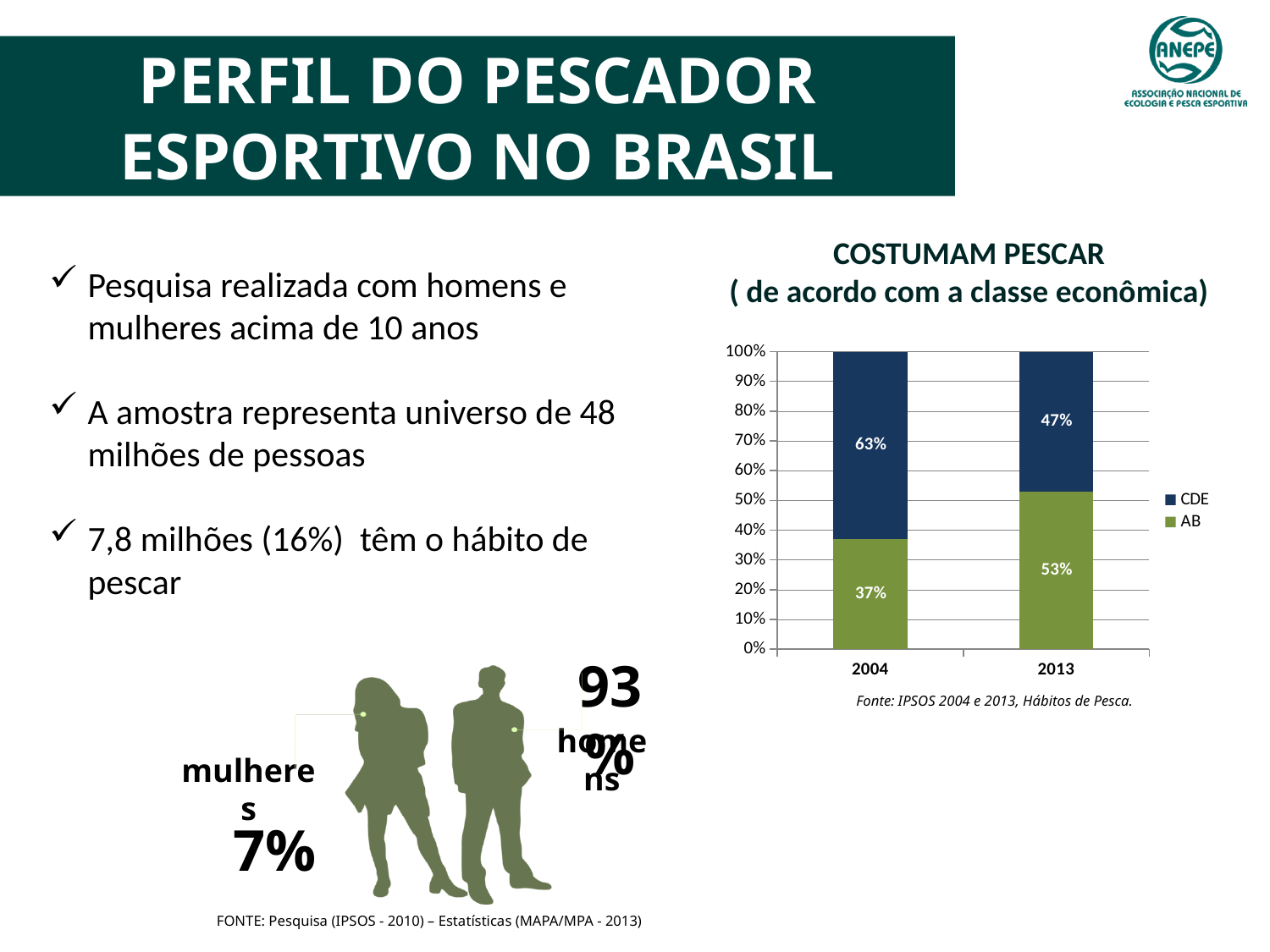
What kind of chart is the 'COSTUMAM PESCAR' chart? Stacked bar chart In the 'COSTUMAM PESCAR' chart, what is the difference between the CDE values for 2004 and 2013? 16% In the 'COSTUMAM PESCAR' chart, which year has the higher value for AB? 2013 In the 'COSTUMAM PESCAR' chart, does the AB value rise or fall from 2004 to 2013? rise In the 'COSTUMAM PESCAR' chart, which year has the lower value for CDE? 2013 What is the value for AB in 2004 in the 'COSTUMAM PESCAR' chart? 37% In the 'COSTUMAM PESCAR' chart, is the AB value in 2004 larger or smaller than the CDE value in 2004? smaller What is the value for CDE in 2013 in the 'COSTUMAM PESCAR' chart? 47% How many series does the legend of the 'COSTUMAM PESCAR' chart list? 2 How many years are shown on the x axis of the 'COSTUMAM PESCAR' chart? 2 What is the value for CDE in 2004 in the 'COSTUMAM PESCAR' chart? 63% What is the value for AB in 2013 in the 'COSTUMAM PESCAR' chart? 53%